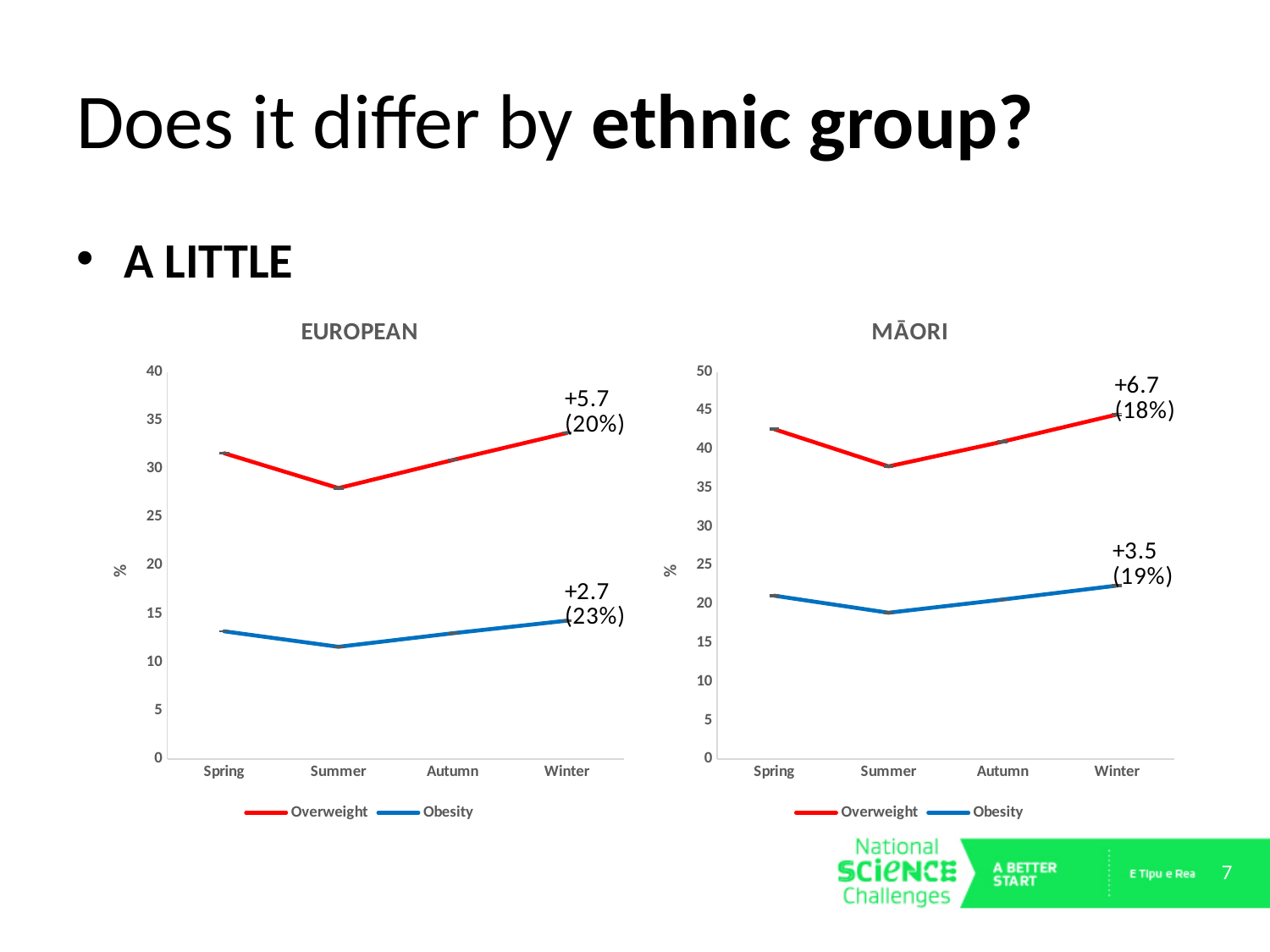
In the EUROPEAN chart, does the Overweight line rise or fall from Summer to Winter? rise In the EUROPEAN chart, is the Overweight value for Summer greater or less than 30? less In the MĀORI chart, is the Overweight value for Spring greater or less than 40? greater In the MĀORI chart, in which season is the Overweight value highest? Winter In the MĀORI chart, is the Obesity value for Winter greater or less than 20? greater In the EUROPEAN chart, what annotation is printed next to the Overweight line at Winter? +5.7 (20%) How many series does the legend of the MĀORI chart list? 2 How many categories are on the x axis of the EUROPEAN chart? 4 What kind of chart is the EUROPEAN chart? line chart In the EUROPEAN chart, in which season is the Overweight value lowest? Summer In the MĀORI chart, what annotation is printed next to the Obesity line at Winter? +3.5 (19%) In the MĀORI chart, in which season is the Obesity value lowest? Summer